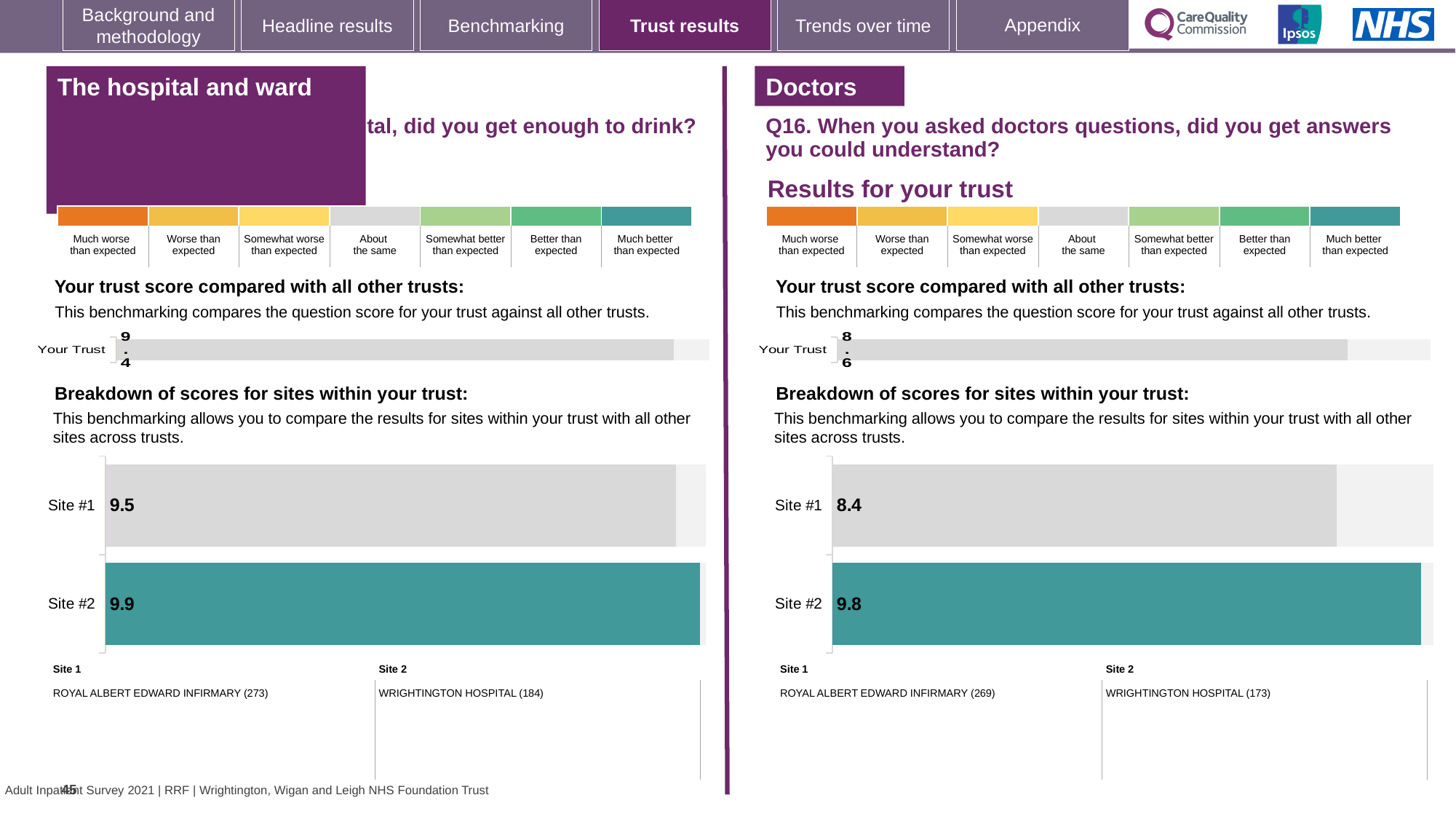
On the left-hand site breakdown chart (did you get enough to drink), what is the difference between the Site #2 and Site #1 scores? 0.4 What type of chart is used for the site breakdown on the right-hand side of the slide? Bar chart On the right-hand site breakdown chart (Q16, doctors), what is the score for Site #1? 8.4 On the left-hand site breakdown chart (did you get enough to drink), what is the score for Site #2? 9.9 On the left-hand 'Your trust score compared with all other trusts' chart, what is the value shown for Your Trust? 9.4 On the right-hand site breakdown chart (Q16, doctors), what is the score for Site #2? 9.8 On the left-hand site breakdown chart (did you get enough to drink), which site has the lower score? Site #1 On the right-hand site breakdown chart (Q16, doctors), what is the difference between the Site #2 and Site #1 scores? 1.4 On the right-hand site breakdown chart (Q16, doctors), which site has the higher score? Site #2 On the left-hand site breakdown chart (did you get enough to drink), what is the score for Site #1? 9.5 How many sites are shown in the left-hand site breakdown chart? 2 On the right-hand 'Your trust score compared with all other trusts' chart (Q16), what is the value shown for Your Trust? 8.6